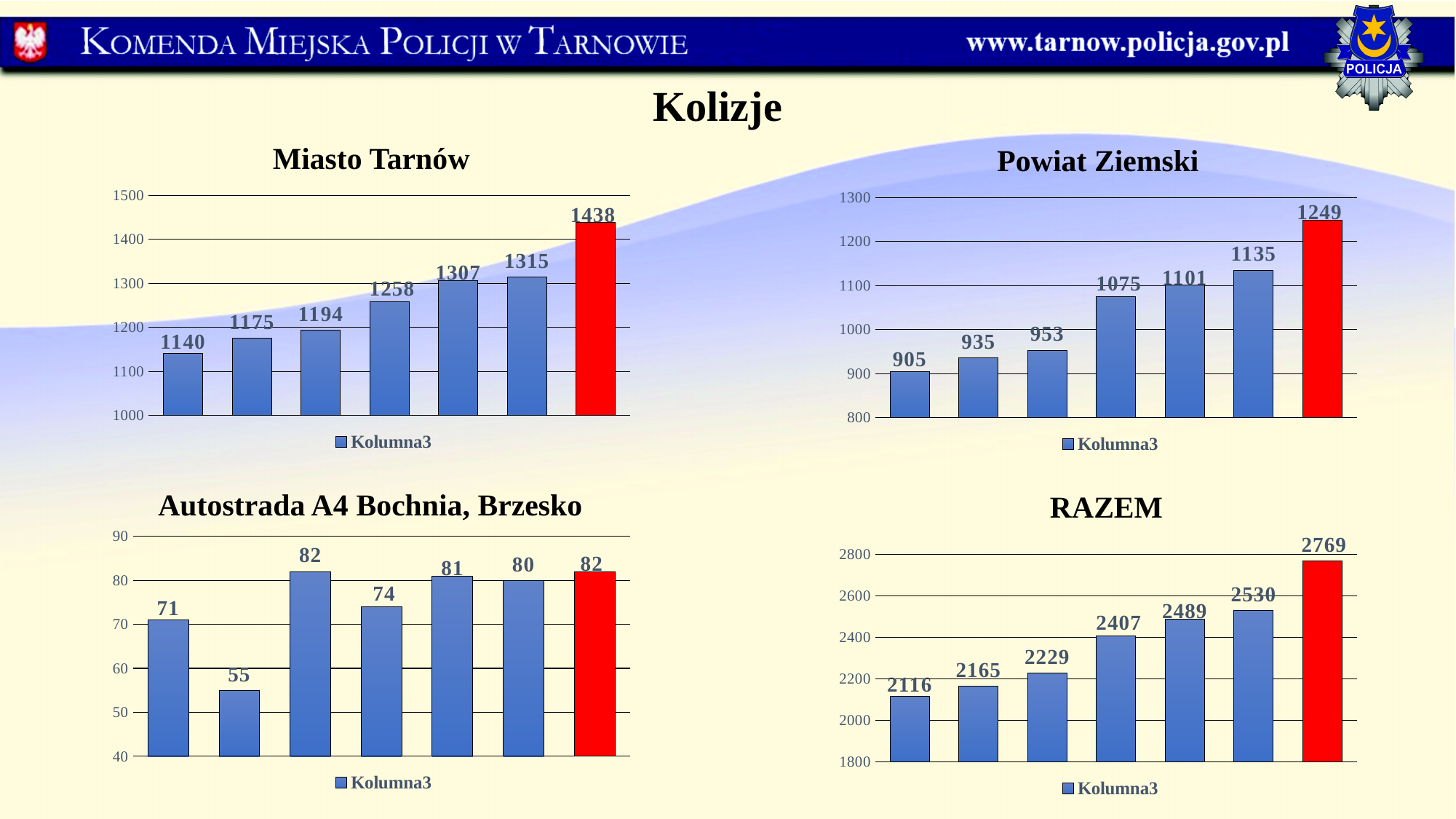
In the 'Autostrada A4 Bochnia, Brzesko' chart, which is larger: the fourth bar (74) or the fifth bar (81)? 81 In the 'RAZEM' chart, what is the highest value shown? 2769 What type of chart is the 'Miasto Tarnów' chart? bar chart In the 'Miasto Tarnów' chart, what is the difference between the last bar (1438) and the first bar (1140)? 298 In the 'Miasto Tarnów' chart, what value is shown on the red (last) bar? 1438 In the 'Powiat Ziemski' chart, what is the difference between the red bar (1249) and the bar before it (1135)? 114 In the 'Powiat Ziemski' chart, do the values rise or fall from left to right? rise How many bars are plotted in the 'RAZEM' chart? 7 In the 'Powiat Ziemski' chart, what value is shown on the first bar? 905 What is the legend entry shown under the 'Autostrada A4 Bochnia, Brzesko' chart? Kolumna3 How many series does the legend of the 'RAZEM' chart list? 1 In the 'Autostrada A4 Bochnia, Brzesko' chart, what is the lowest value shown? 55